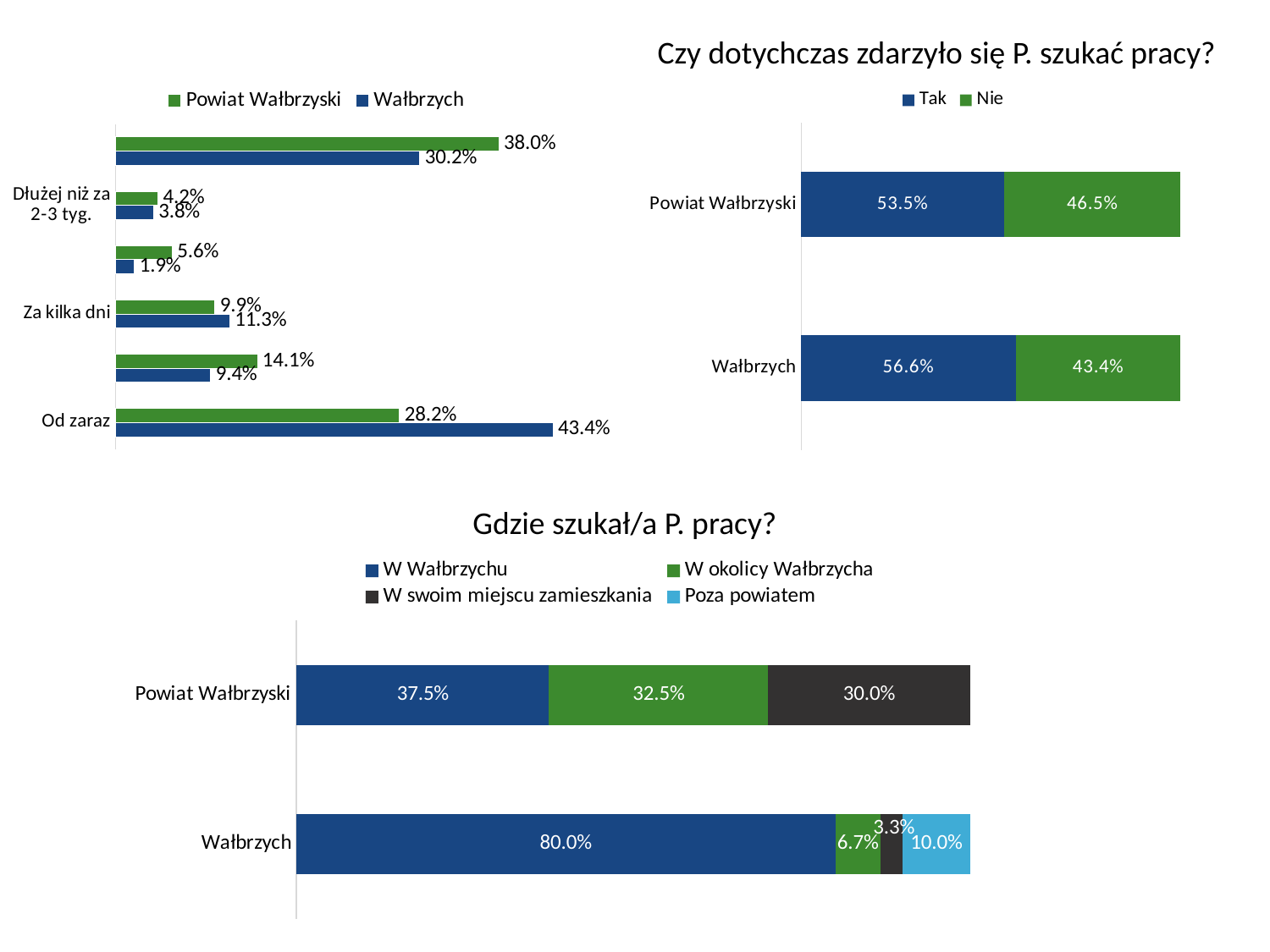
In the chart titled "Gdzie szukał/a P. pracy?", what is the value for Poza powiatem for Wałbrzych? 10.0% In the chart titled "Gdzie szukał/a P. pracy?", which series has the largest value for Wałbrzych? W Wałbrzychu In the top-left chart, what is the value for Wałbrzych for Od zaraz? 43.4% In the top-left chart, what is the value for Powiat Wałbrzyski for Za kilka dni? 9.9% What type of chart is the chart titled "Czy dotychczas zdarzyło się P. szukać pracy?"? Stacked bar chart In the chart titled "Czy dotychczas zdarzyło się P. szukać pracy?", what is the value for Nie for Powiat Wałbrzyski? 46.5% In the chart titled "Gdzie szukał/a P. pracy?", how many series does the legend list? 4 In the top-left chart, which is larger for Dłużej niż za 2-3 tyg.: Powiat Wałbrzyski or Wałbrzych? Powiat Wałbrzyski In the chart titled "Czy dotychczas zdarzyło się P. szukać pracy?", what is the difference between the Tak values for Wałbrzych and Powiat Wałbrzyski? 3.1% In the chart titled "Gdzie szukał/a P. pracy?", what is the value for W Wałbrzychu for Wałbrzych? 80.0% In the chart titled "Gdzie szukał/a P. pracy?", what is the value for W swoim miejscu zamieszkania for Powiat Wałbrzyski? 30.0% In the chart titled "Czy dotychczas zdarzyło się P. szukać pracy?", what is the value for Tak for Wałbrzych? 56.6%